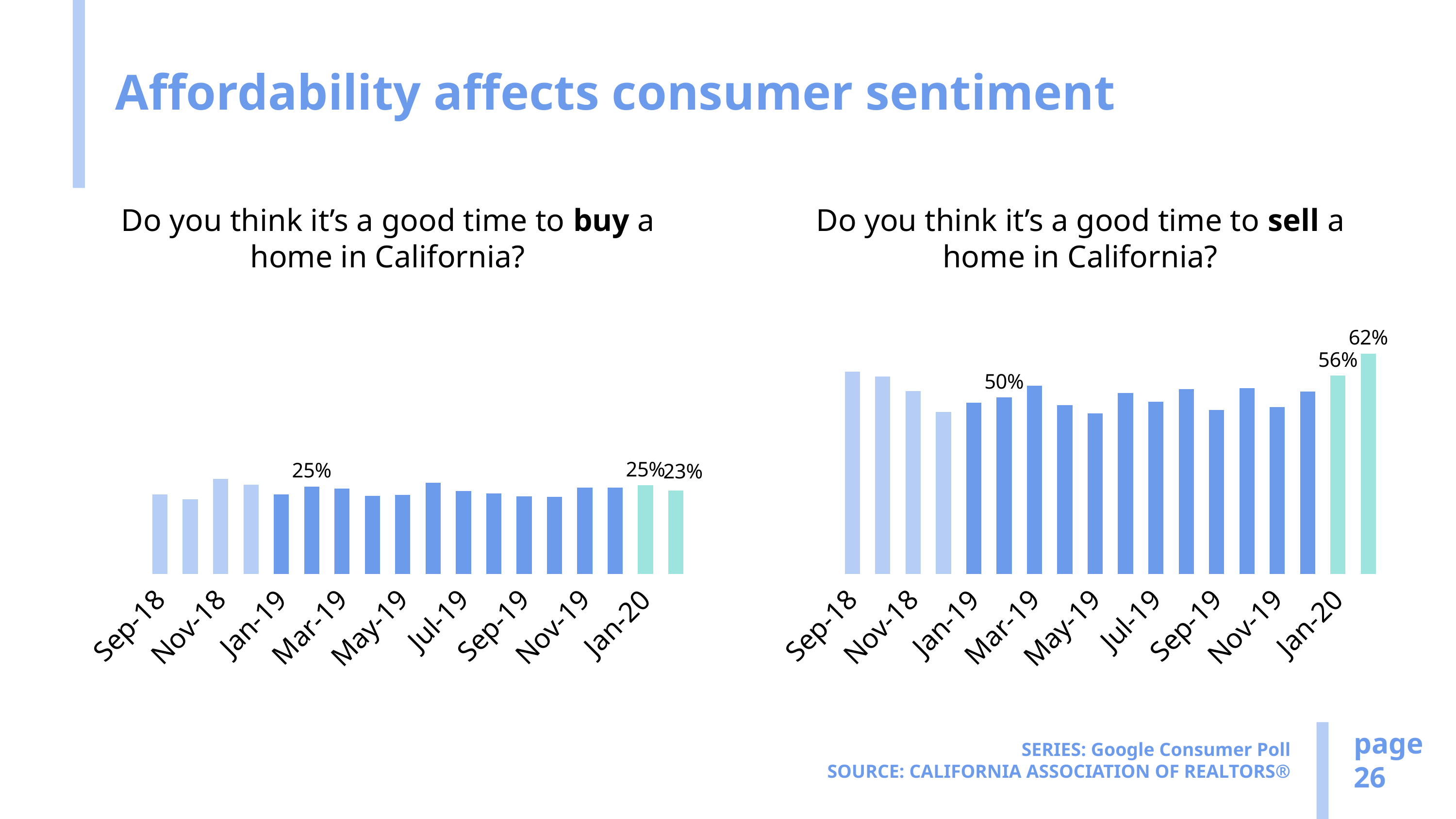
On the 'good time to sell' chart, how much higher is the rightmost bar (62%) than Jan-20 (56%)? 6 percentage points On the 'good time to sell' chart, what is the highest labeled value? 62% On the 'good time to sell' chart, what is the value for Jan-20? 56% For Jan-20, which is larger: the 'good time to buy' value or the 'good time to sell' value? good time to sell (56%) On the 'good time to buy' chart, what is the value for Jan-20? 25% On the 'good time to sell' chart, do the values rise or fall from Sep-18 to Jan-19? fall On the 'good time to sell' chart, which is larger: Sep-18 or Jan-19? Sep-18 How many bars are plotted on the 'good time to buy' chart? 18 On the 'good time to buy' chart, what value is labeled on the rightmost bar? 23% On the 'good time to sell' chart, what value is labeled on the rightmost bar? 62% What kind of chart is used for the 'good time to sell' question? bar chart On the 'good time to buy' chart, what is the difference between Jan-20 (25%) and the rightmost bar (23%)? 2 percentage points